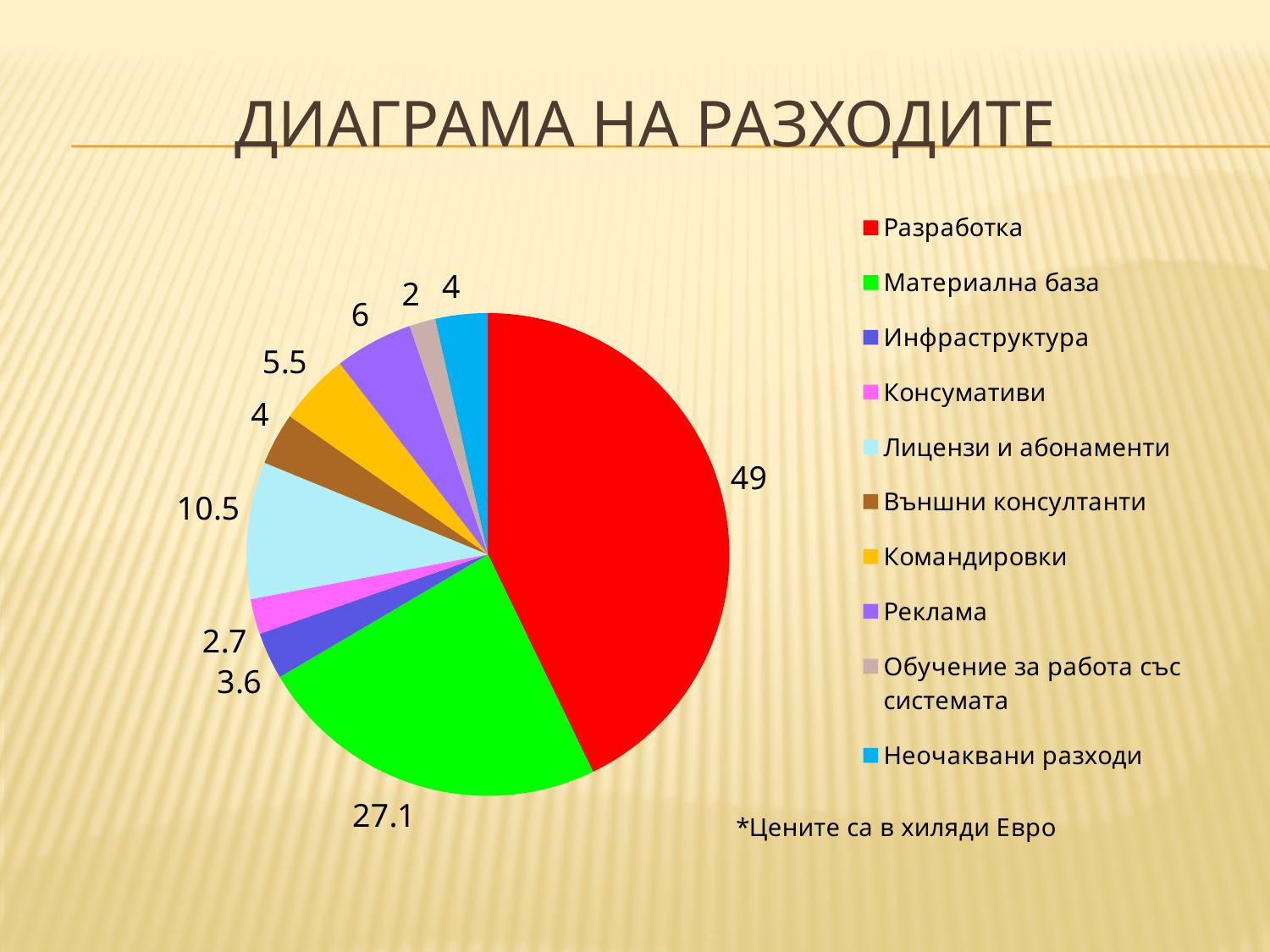
What is the value for Материална база? 27.1 What is the value for Командировки? 5.5 What kind of chart is shown on the slide? pie chart Which category has the smallest slice? Обучение за работа със системата What is the value for Разработка? 49 What colour is the slice for Неочаквани разходи? blue How many categories does the pie chart have? 10 What is the title of the slide's chart? ДИАГРАМА НА РАЗХОДИТЕ Which is larger, the value for Реклама or the value for Инфраструктура? Реклама What is the difference between the values for Разработка and Материална база? 21.9 Which category has the largest slice? Разработка What is the value for Лицензи и абонаменти? 10.5